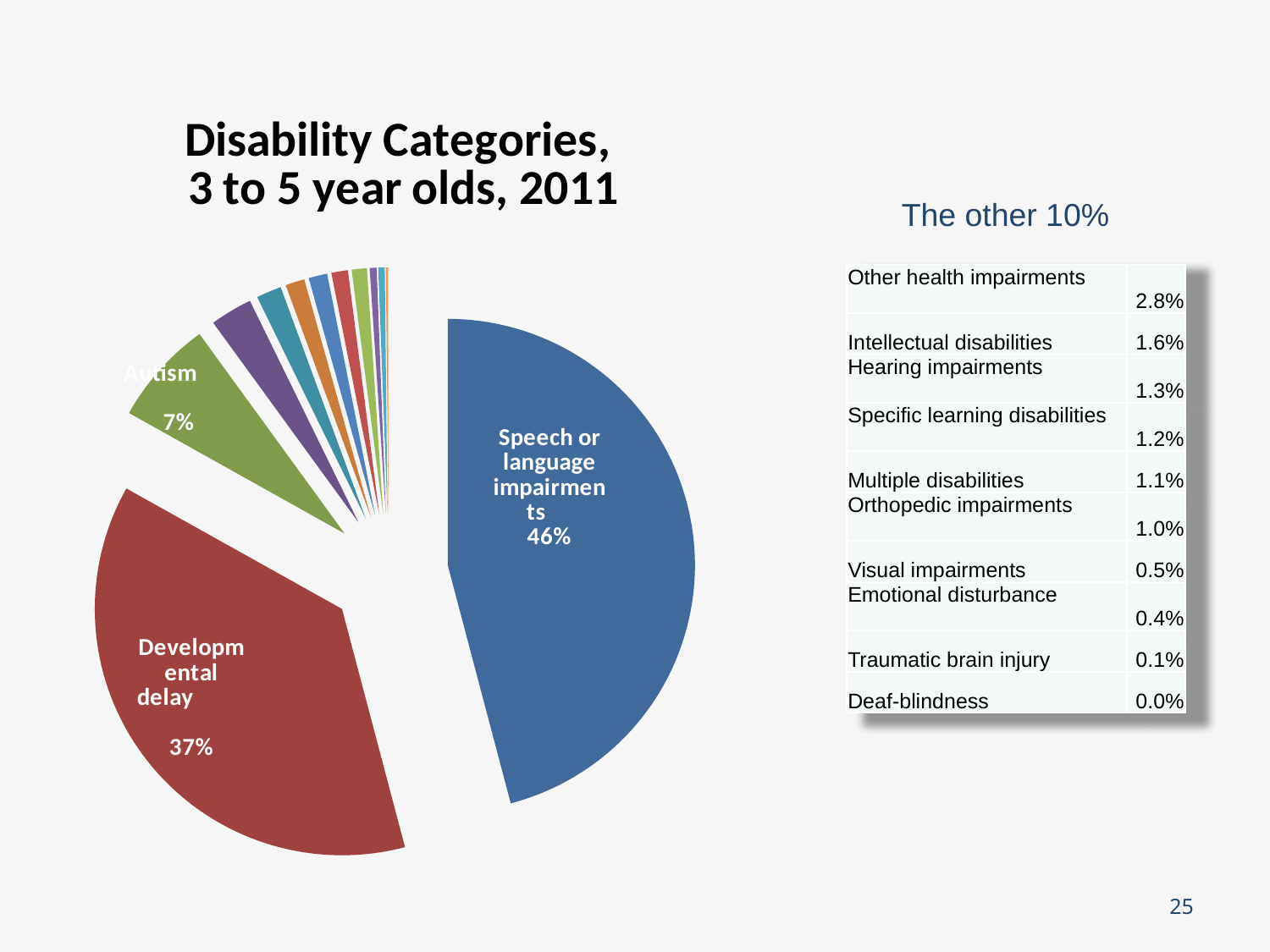
What do the three labeled slices (Speech or language impairments, Developmental delay, Autism) add up to? 90% What is the title of the chart? Disability Categories, 3 to 5 year olds, 2011 Which slice is larger, Developmental delay or Autism? Developmental delay What is the difference in percentage points between Speech or language impairments and Developmental delay? 9 percentage points What share of the pie does Autism represent? 7% What percentage of the pie is Speech or language impairments? 46% Which slice is larger, Speech or language impairments or Developmental delay? Speech or language impairments Which category has the largest slice of the pie? Speech or language impairments Of the three labeled slices, which is the smallest? Autism What is the difference in percentage points between Developmental delay and Autism? 30 percentage points What percentage of the pie is Developmental delay? 37% What type of chart is shown on the slide? Pie chart